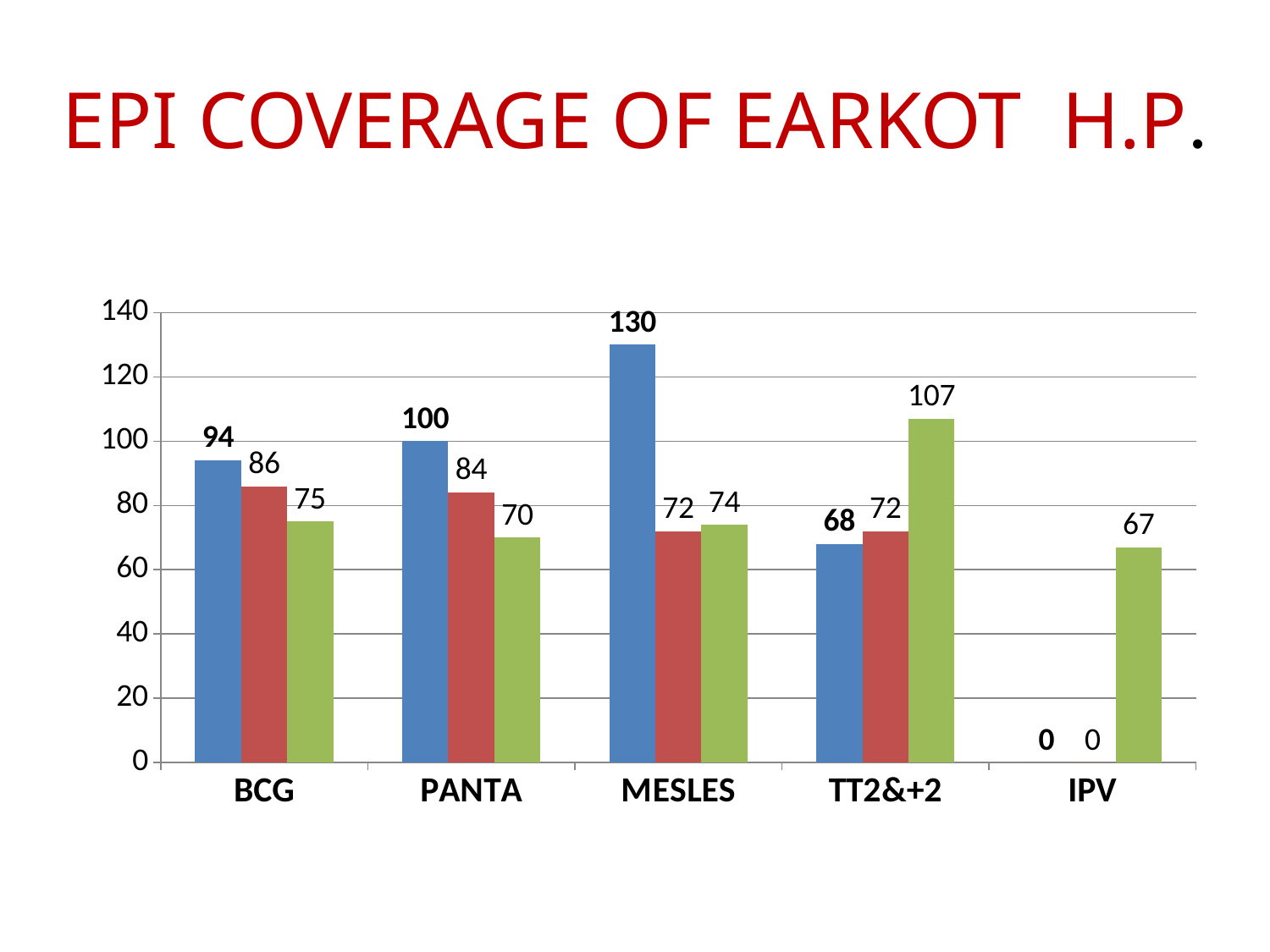
What kind of chart is shown on the slide? bar chart What is the value of the blue bar for MESLES? 130 Is the value of the blue bar for BCG greater or less than 80? greater What is the value of the green bar for TT2&+2? 107 How many categories are shown on the x axis? 5 What is the title of the slide? EPI COVERAGE OF EARKOT H.P. What is the value of the red bar for BCG? 86 What is the value of the green bar for IPV? 67 Which category has the highest blue bar? MESLES Which is larger for TT2&+2, the blue bar or the green bar? the green bar What is the difference between the blue bar and the green bar for PANTA? 30 Which category has the lowest green bar? IPV